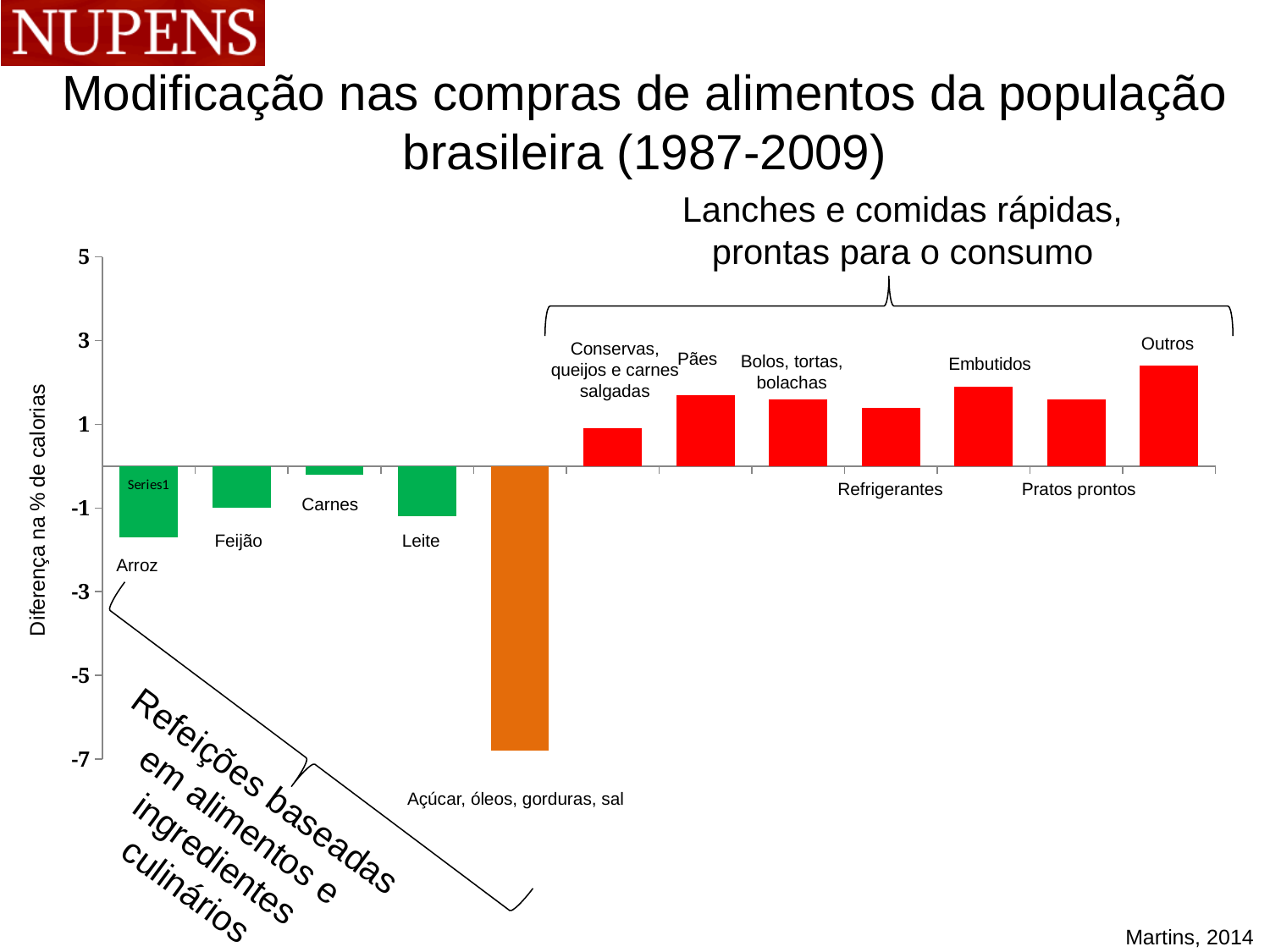
How many food categories (bars) are plotted in the chart? 12 What is the label of the vertical axis of the chart? Diferença na % de calorias Which category has the highest value in the chart? Outros Which has the larger value, Embutidos or Refrigerantes? Embutidos Is the value for Carnes greater or less than -1? greater How many bars in the chart have negative values? 5 Is the value for Outros greater or less than 1? greater Which category has the lowest value in the chart? Açúcar, óleos, gorduras, sal Which has the larger value, Outros or Pães? Outros What kind of chart is shown on the slide? bar chart Is the value for Arroz greater or less than -1? less